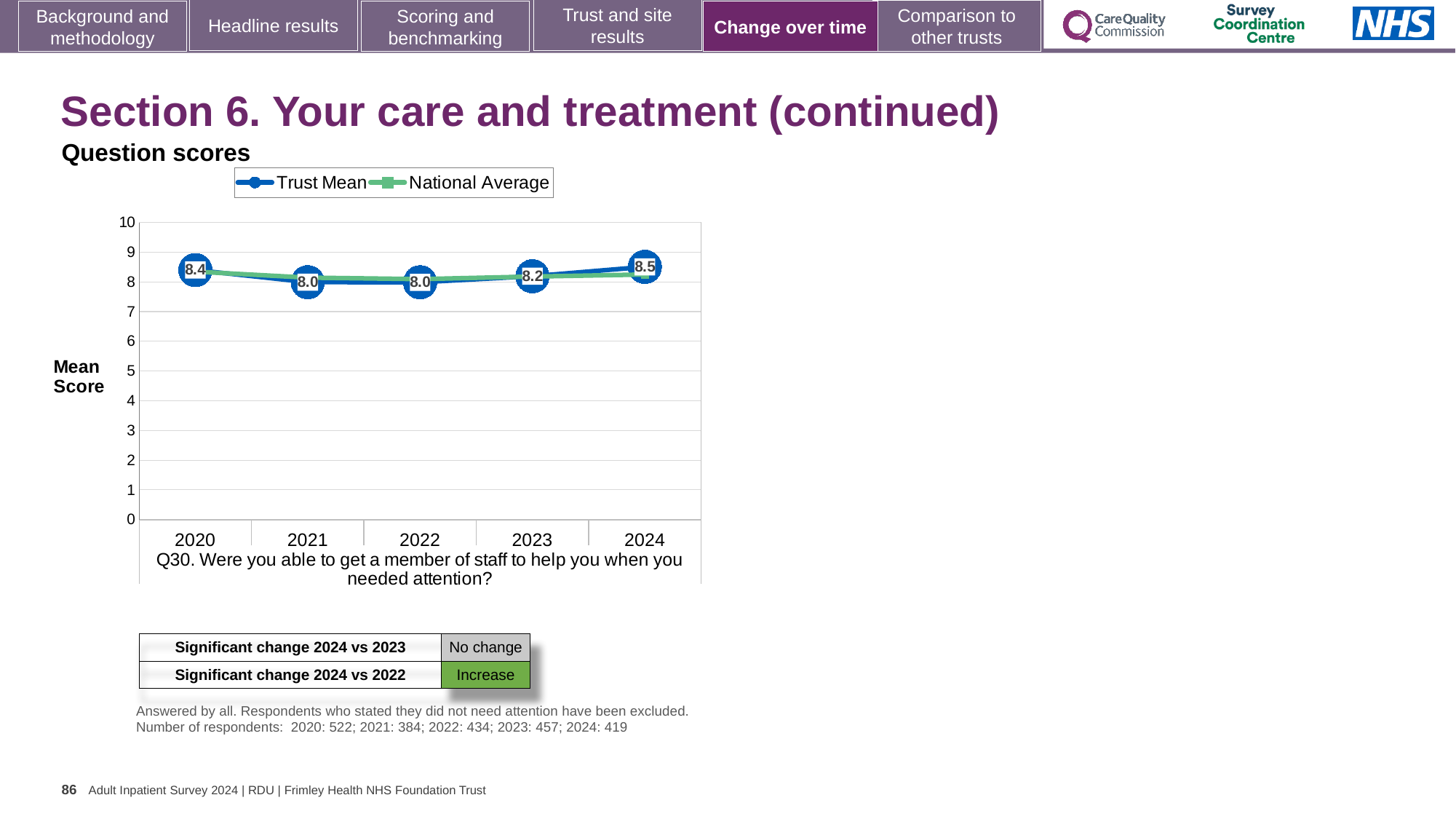
Which year has the larger Trust Mean, 2020 or 2023? 2020 What is the difference between the Trust Mean in 2024 and in 2022? 0.5 What is the label on the y axis? Mean Score Does the Trust Mean rise or fall from 2022 to 2024? Rise How many series does the legend list? 2 What kind of chart is shown? Line chart What is the Trust Mean score for 2020? 8.4 In which year is the Trust Mean highest? 2024 What is the Trust Mean score for 2023? 8.2 How many years are shown on the x axis? 5 What is the Trust Mean score for 2024? 8.5 Is the Trust Mean for 2021 greater or less than 5? greater